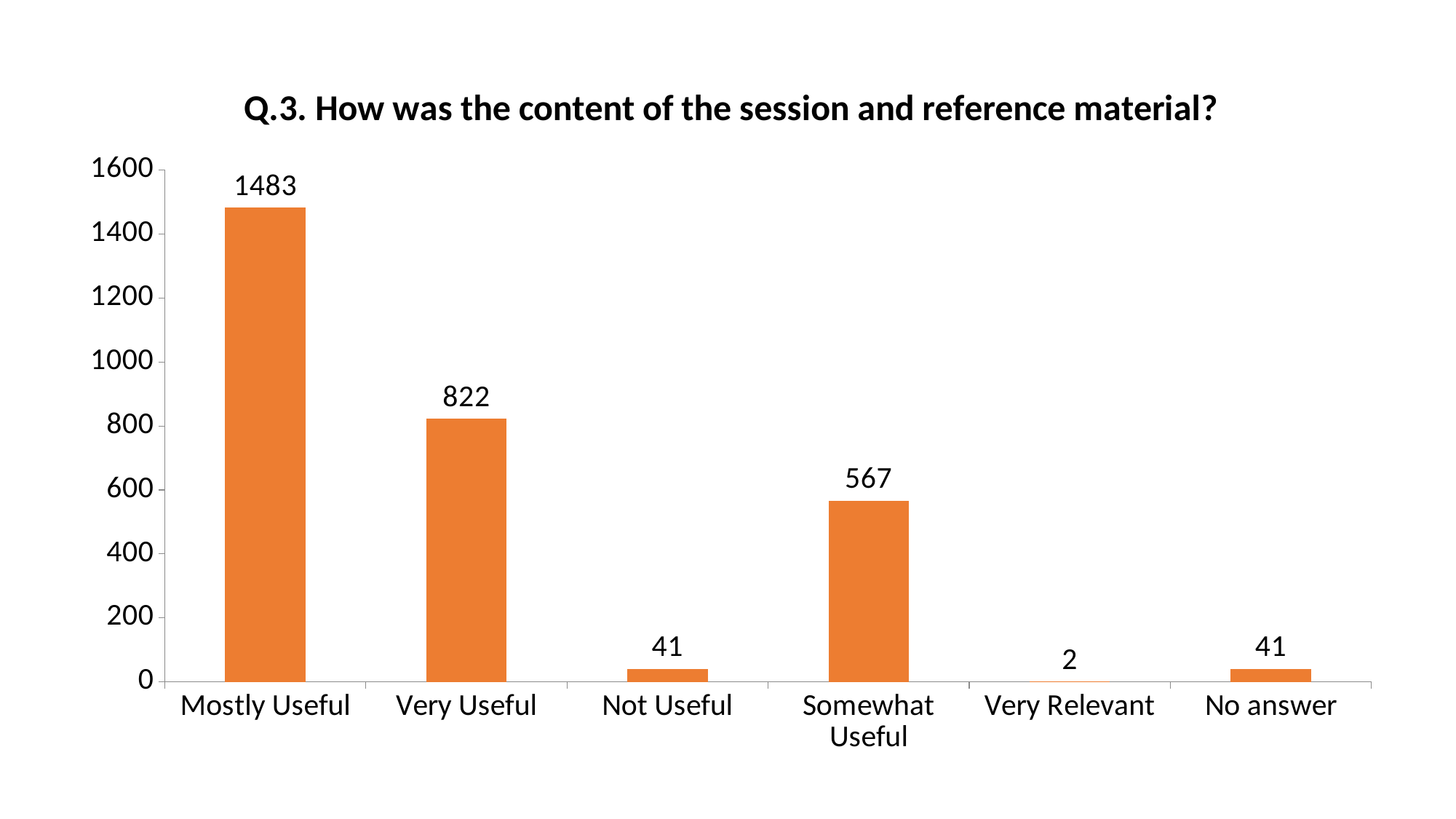
What kind of chart is shown on the slide? bar chart Which category has the highest value? Mostly Useful What is the value for Mostly Useful? 1483 Is the value for Somewhat Useful greater or less than 600? less What is the difference between the values for Mostly Useful and Very Useful? 661 Which is larger, the value for Very Useful or the value for Somewhat Useful? Very Useful Which category has the lowest value? Very Relevant What is the value for Somewhat Useful? 567 What is the value for Very Useful? 822 What is the title of the chart? Q.3. How was the content of the session and reference material? What is the value for Very Relevant? 2 How many categories are shown on the x axis? 6